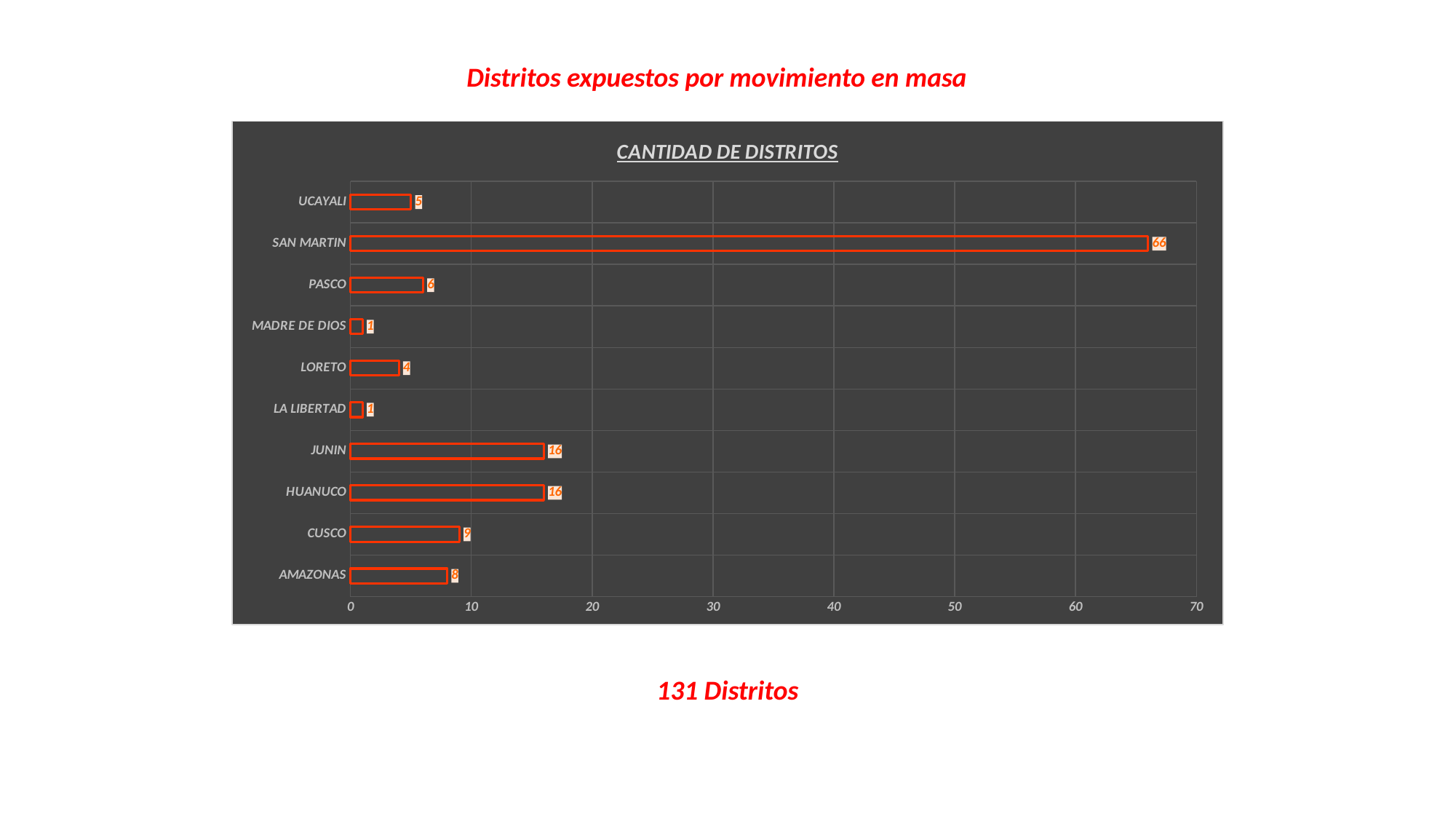
What is the title of the chart? CANTIDAD DE DISTRITOS Is the value for SAN MARTIN greater or less than 60? greater What is the value for SAN MARTIN? 66 What kind of chart is shown? Bar chart What is the difference between the values for CUSCO and AMAZONAS? 1 How many categories are shown on the chart? 10 Which category has the highest value? SAN MARTIN What is the value for LORETO? 4 What is the difference between the values for SAN MARTIN and JUNIN? 50 What is the value for JUNIN? 16 Which is larger, the value for PASCO or the value for UCAYALI? PASCO What is the value for AMAZONAS? 8